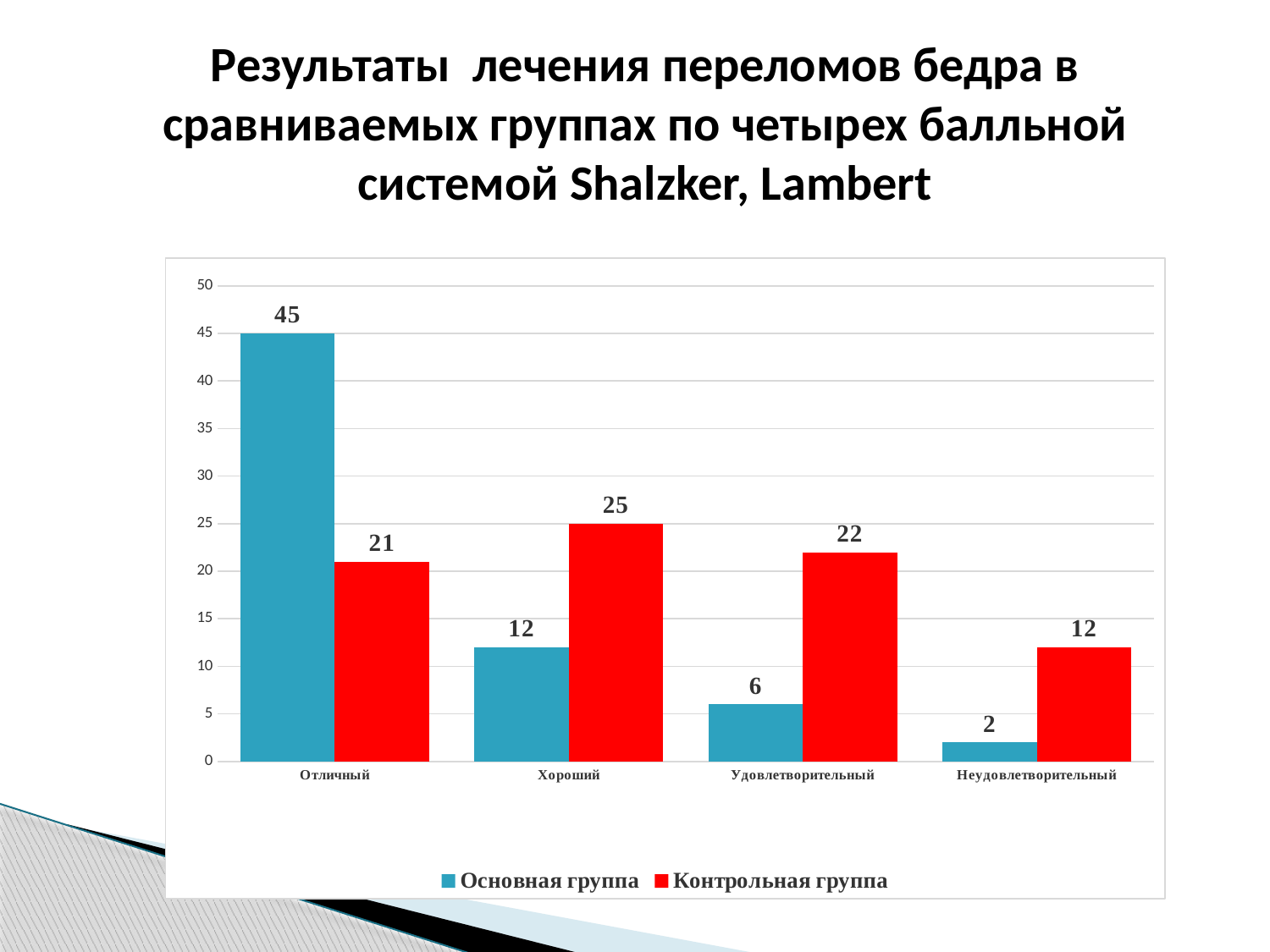
What is the value for Основная группа in the Неудовлетворительный category? 2 What is the value for Основная группа in the Отличный category? 45 Which category has the lowest value for Контрольная группа? Неудовлетворительный What is the value for Контрольная группа in the Удовлетворительный category? 22 Which is larger in the Хороший category: Основная группа or Контрольная группа? Контрольная группа What colour represents Контрольная группа in the chart? Red How many series does the legend list? 2 What is the difference between Основная группа and Контрольная группа in the Отличный category? 24 Which category has the highest value for Основная группа? Отличный What kind of chart is shown on the slide? Bar chart What is the value for Контрольная группа in the Хороший category? 25 How many categories are shown on the x axis? 4